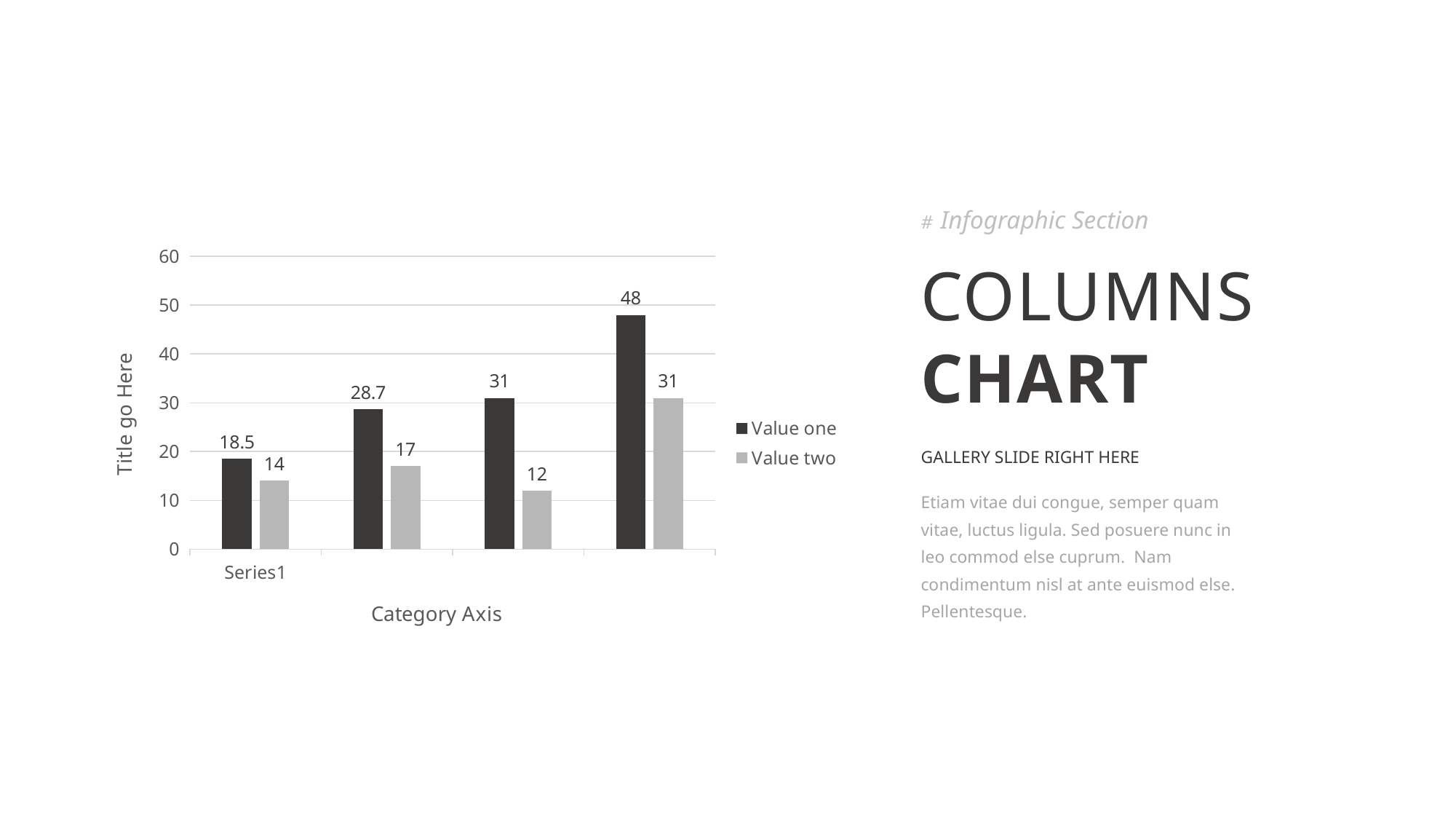
What is the lowest value shown for the Value two series? 12 Do the Value one bars rise or fall from left to right along the category axis? Rise What kind of chart is shown on the slide? Bar chart What is the value of the Value one bar for Series1? 18.5 How many series does the legend list? 2 What is the highest value shown for the Value one series? 48 For Series1, which is larger, Value one or Value two? Value one How many groups of bars are plotted along the category axis? 4 What is the title of the vertical axis? Title go Here What is the value of the Value two bar for Series1? 14 What is the title of the horizontal axis? Category Axis For Series1, what is the difference between Value one and Value two? 4.5